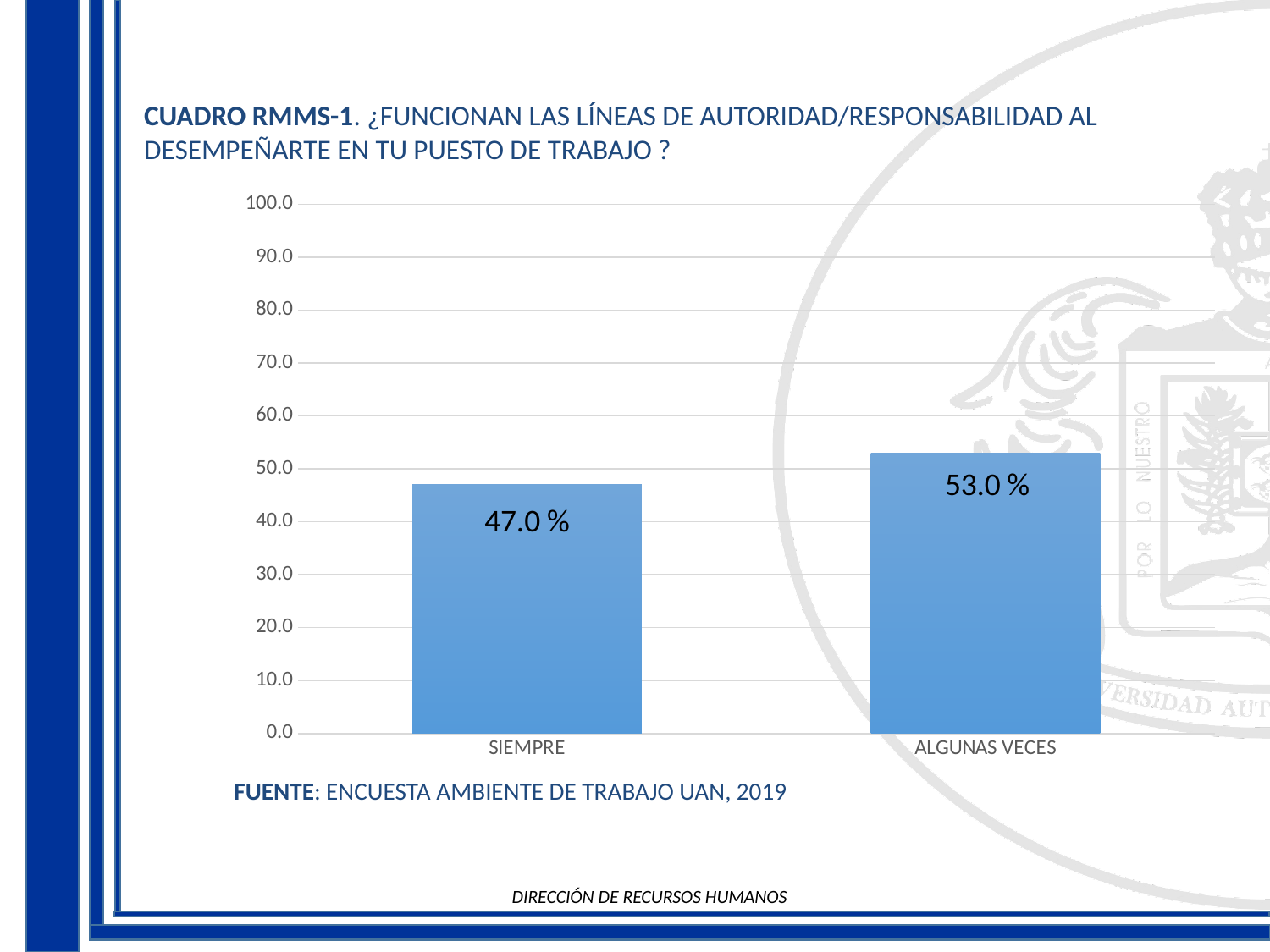
What source is cited below the chart? ENCUESTA AMBIENTE DE TRABAJO UAN, 2019 What is the value for SIEMPRE? 47.0 % Which is larger, the value for SIEMPRE or the value for ALGUNAS VECES? ALGUNAS VECES What is the value for ALGUNAS VECES? 53.0 % Which category has the lowest value? SIEMPRE Is the value for SIEMPRE greater or less than 50.0? less How many categories are shown on the x axis? 2 What is the difference between the values for ALGUNAS VECES and SIEMPRE? 6.0 % Which category has the highest value? ALGUNAS VECES Is the value for ALGUNAS VECES greater or less than 50.0? greater What kind of chart is shown on the slide? bar chart What is the maximum value shown on the y axis? 100.0